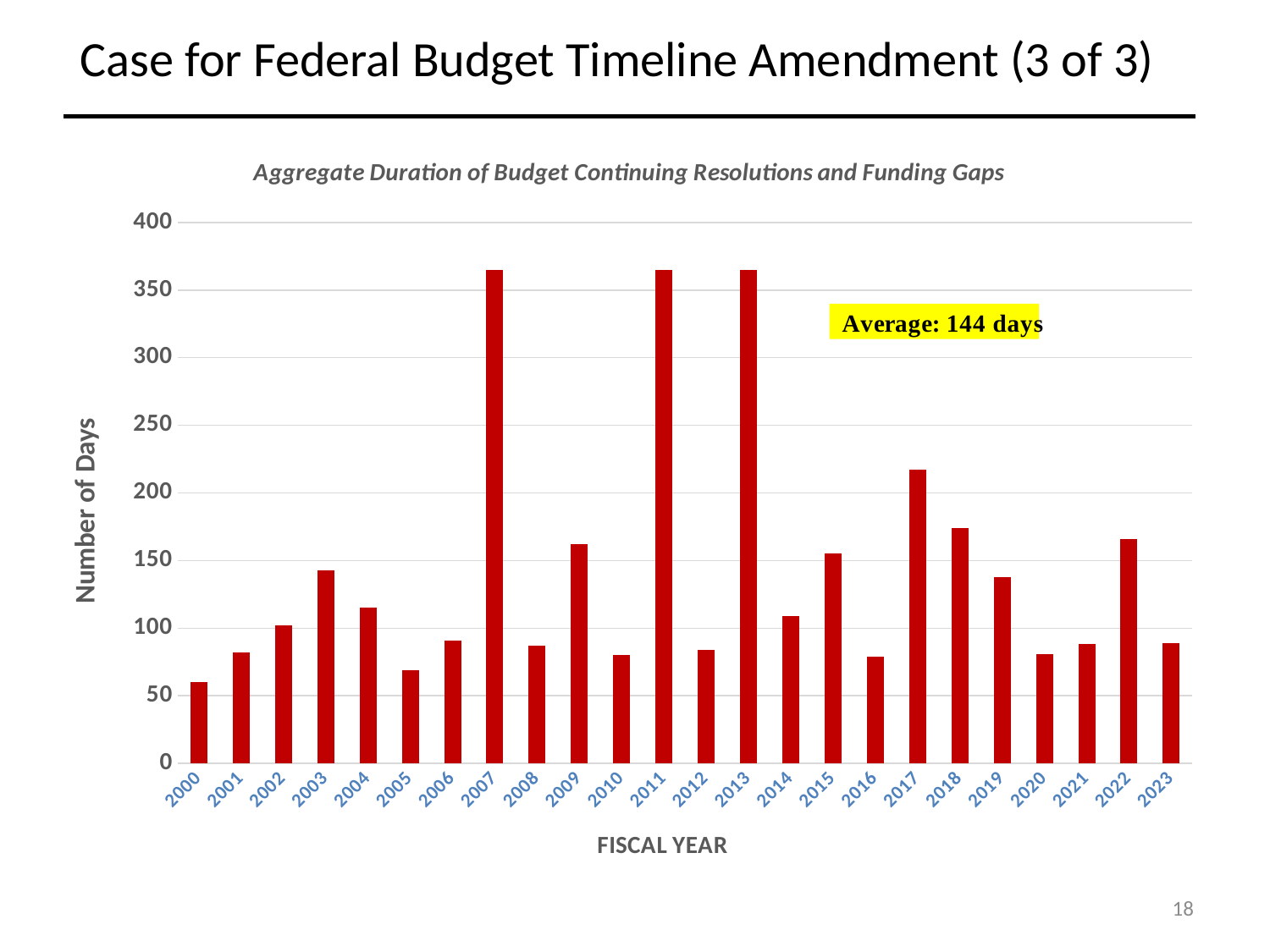
Is the value for fiscal year 2017 greater or less than 200? greater How many fiscal years are plotted on the chart? 24 Is the value for fiscal year 2007 greater or less than 350? greater Which fiscal year has the larger value, 2009 or 2010? 2009 What kind of chart is shown on the slide? Bar chart Which fiscal year has the larger value, 2002 or 2003? 2003 What average value is highlighted in the annotation on the chart? 144 days Which fiscal year has the larger value, 2017 or 2018? 2017 What is the title of the chart? Aggregate Duration of Budget Continuing Resolutions and Funding Gaps Is the value for fiscal year 2016 greater or less than 100? less